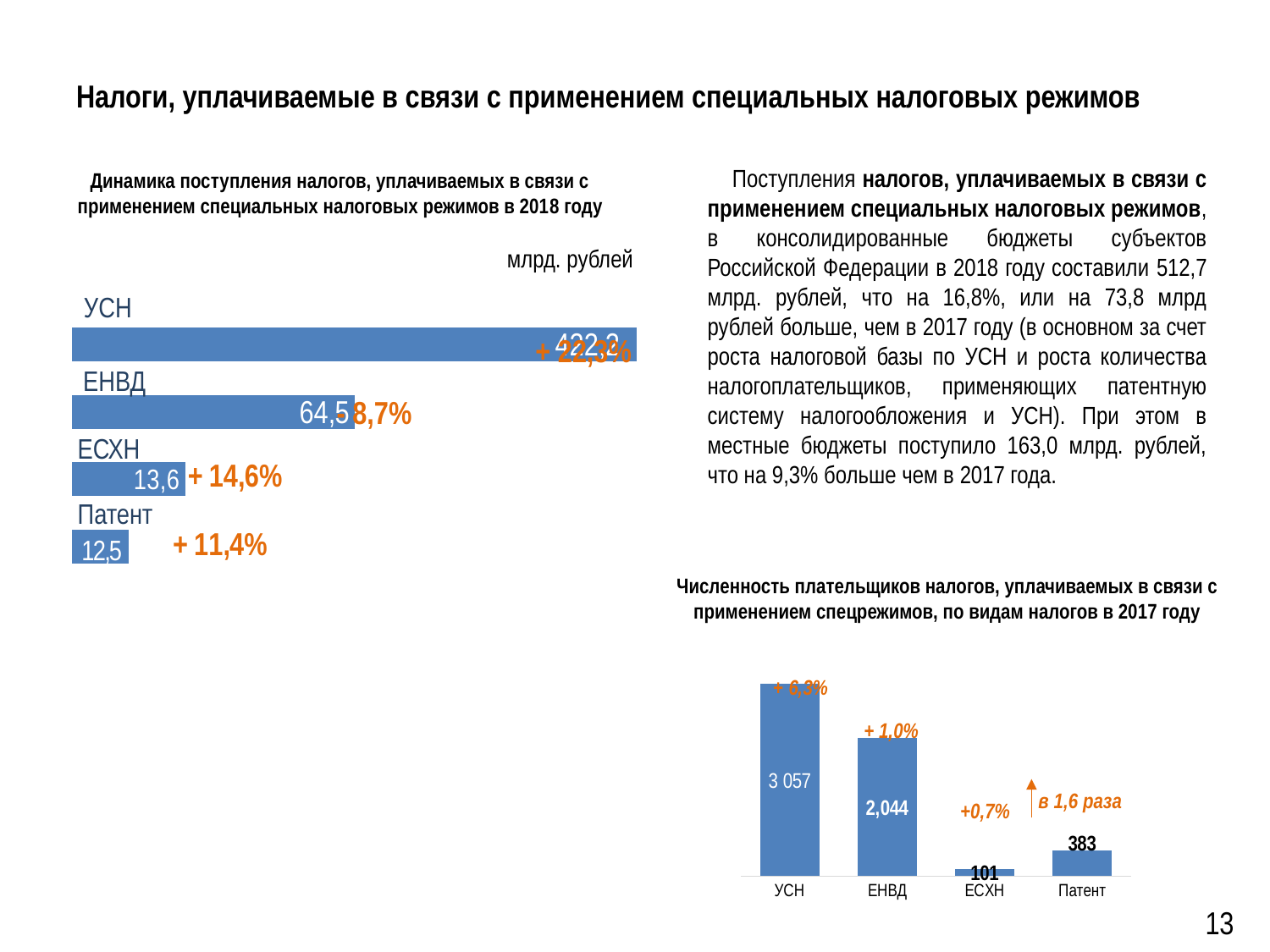
On the left chart (Динамика поступления налогов ... в 2018 году), what is the difference between the values for ЕНВД and ЕСХН? 50,9 On the left chart (Динамика поступления налогов ... в 2018 году), what is the value for Патент? 12,5 On the left chart (Динамика поступления налогов ... в 2018 году), what is the value for ЕНВД? 64,5 On the right chart (Численность плательщиков налогов ... в 2017 году), which category has the lowest value? ЕСХН On the right chart (Численность плательщиков налогов ... в 2017 году), what kind of chart is it? bar chart On the left chart (Динамика поступления налогов ... в 2018 году), which category has the highest value? УСН On the right chart (Численность плательщиков налогов ... в 2017 году), how many categories are shown? 4 On the right chart (Численность плательщиков налогов ... в 2017 году), what is the value for Патент? 383 On the left chart (Динамика поступления налогов ... в 2018 году), what unit is stated for the values? млрд. рублей On the left chart (Динамика поступления налогов ... в 2018 году), what is the value for ЕСХН? 13,6 On the right chart (Численность плательщиков налогов ... в 2017 году), what is the value for УСН? 3 057 On the left chart (Динамика поступления налогов ... в 2018 году), what growth percentage is shown next to ЕСХН? + 14,6%